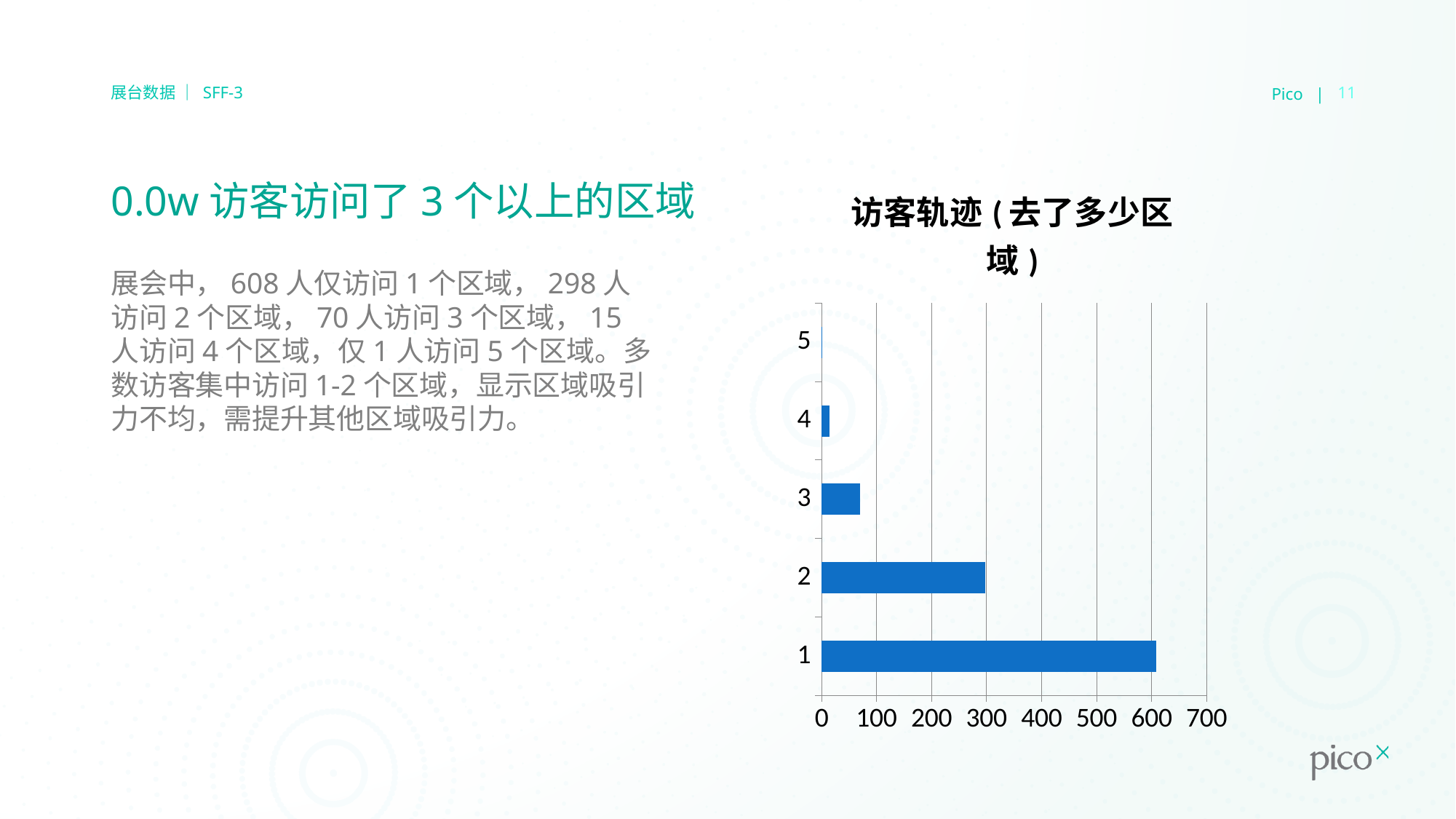
According to the slide, how many people visited only 1 area (category 1)? 608 Is the value for category 1 greater or less than 600? greater How many categories are plotted in the chart? 5 What is the difference between the number of people who visited 1 area and those who visited 2 areas, as stated on the slide? 310 What is the title of the chart? 访客轨迹（去了多少区域） Which category has the longest bar in the chart? 1 Which has a larger value, category 2 or category 3? 2 Is the value for category 2 greater or less than 200? greater According to the slide, how many people visited 2 areas (category 2)? 298 Is the value for category 3 greater or less than 100? less What type of chart is shown on the slide? bar chart Which category has the shortest bar in the chart? 5